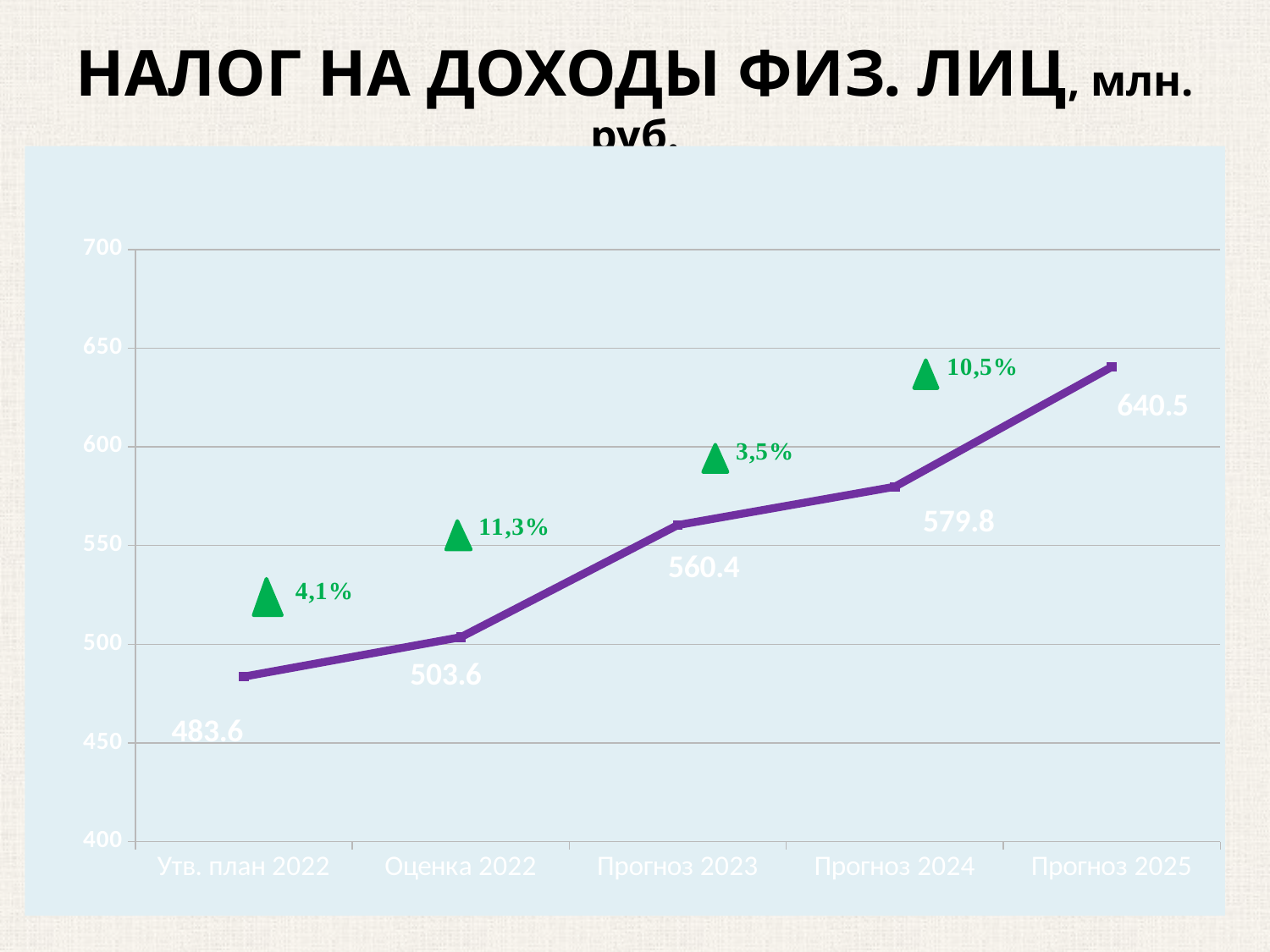
Do the values rise or fall from Утв. план 2022 to Прогноз 2025? rise What kind of chart is shown on the slide? line chart How many categories are plotted on the x axis? 5 Which category has the highest value? Прогноз 2025 Is the value for Прогноз 2024 greater or less than 600? less What is the value for Прогноз 2023? 560.4 Which category has the lowest value? Утв. план 2022 What is the difference between the values for Оценка 2022 and Утв. план 2022? 20.0 What is the value for Утв. план 2022? 483.6 Which is larger, the value for Оценка 2022 or the value for Прогноз 2023? Прогноз 2023 What is the difference between the values for Прогноз 2025 and Прогноз 2024? 60.7 What is the value for Прогноз 2025? 640.5